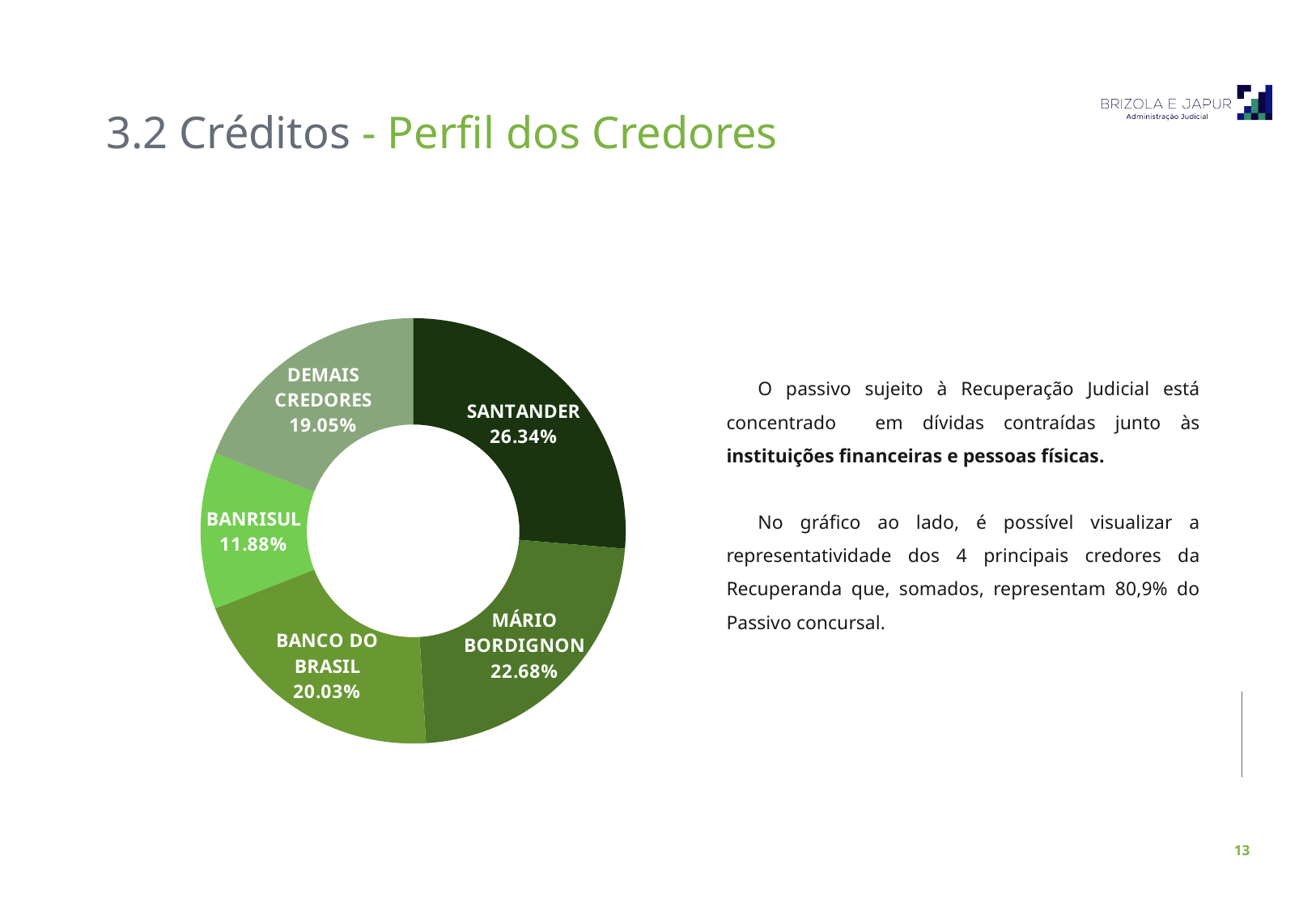
How many categories are shown in the chart? 5 Which is larger, the share of BANCO DO BRASIL or the share of DEMAIS CREDORES? BANCO DO BRASIL What is the value for DEMAIS CREDORES? 19.05% What is the title of the slide containing the chart? 3.2 Créditos - Perfil dos Credores What kind of chart is shown on the slide? Doughnut chart What percentage is shown for MÁRIO BORDIGNON? 22.68% Which category has the largest share of the chart? SANTANDER What is the value shown for BANRISUL? 11.88% What is the combined share of SANTANDER and MÁRIO BORDIGNON? 49.02% What is the difference between the shares of SANTANDER and BANCO DO BRASIL? 6.31% What share of the chart does SANTANDER represent? 26.34% Which category has the smallest share of the chart? BANRISUL